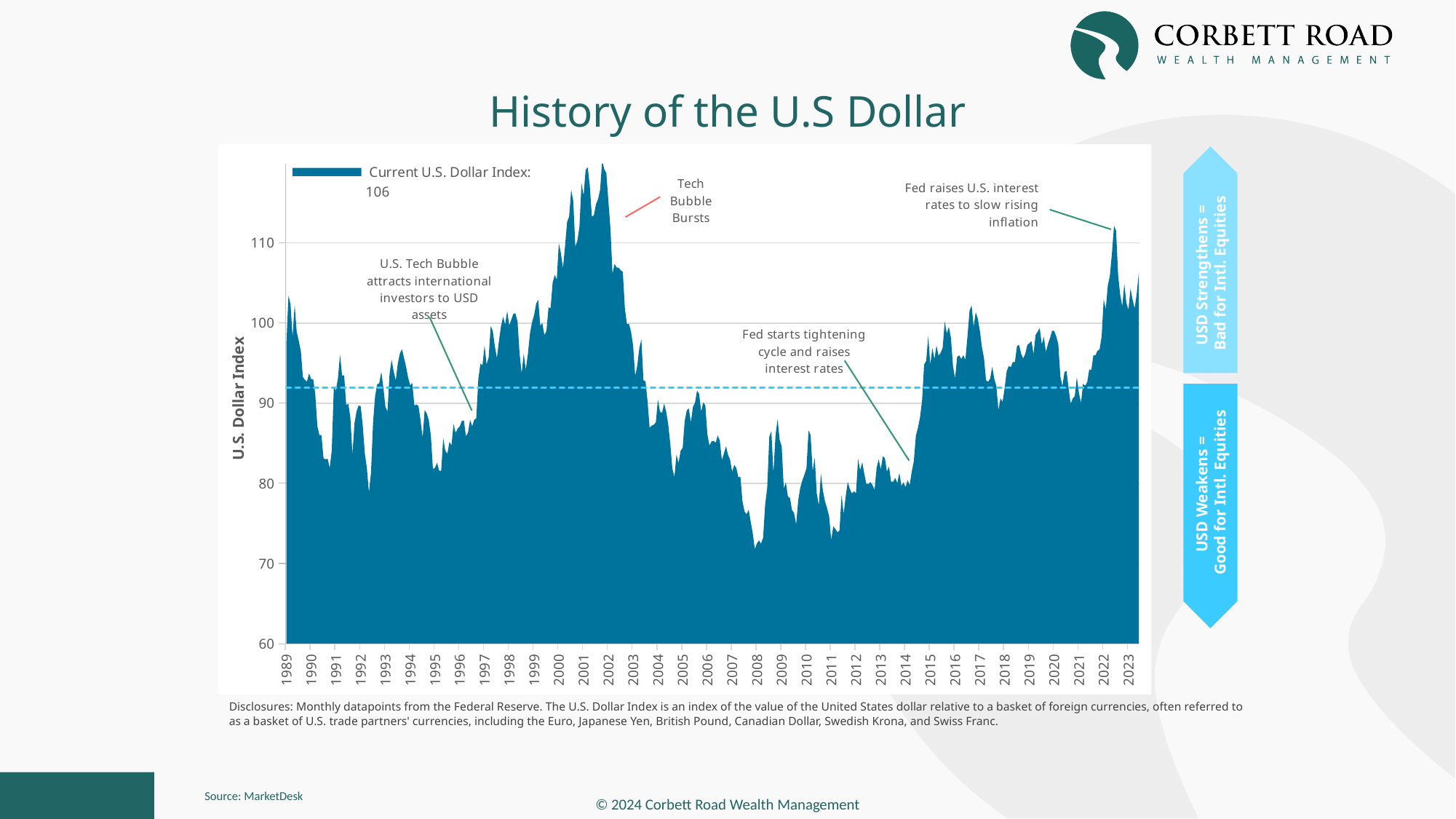
Which is higher: the peak of the U.S. Dollar Index around 2001-2002 or the peak around 2022? The peak around 2001-2002 Around which year does the U.S. Dollar Index reach its lowest point on the chart? 2008 What is the label on the vertical axis of the chart? U.S. Dollar Index What is the current U.S. Dollar Index value shown in the chart legend? 106 Is the value of the U.S. Dollar Index in 1995 greater or less than 90? less What is the title of the chart? History of the U.S Dollar How many year labels are shown on the x axis of the chart? 35 Is the value of the U.S. Dollar Index at its low point around 2008 greater or less than 80? less Does the U.S. Dollar Index rise or fall between 2002 and 2008? Fall Is the value of the U.S. Dollar Index in 2014 greater or less than 90? less What kind of chart is shown on the slide? Area chart